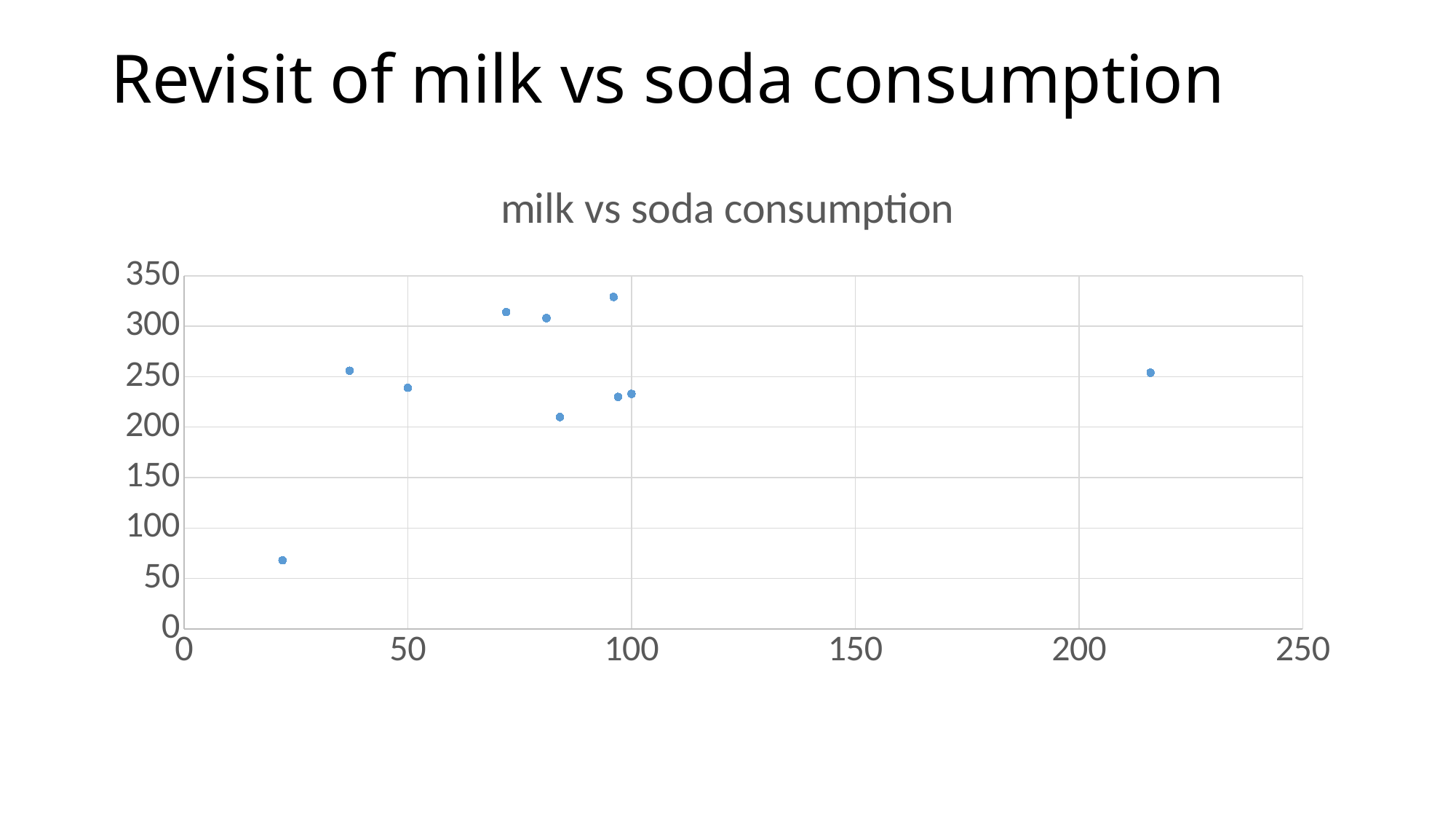
What kind of chart is shown on the slide? scatter chart Is the y value of the highest point greater or less than 300? greater How many points have an x value greater than 150? 1 Is the x value of the rightmost point greater or less than 200? greater How many data points are plotted in the chart? 10 What is the title of the chart? milk vs soda consumption How many points have a y value below 100? 1 Is the y value of the rightmost point greater or less than 200? greater What is the maximum value shown on the vertical axis? 350